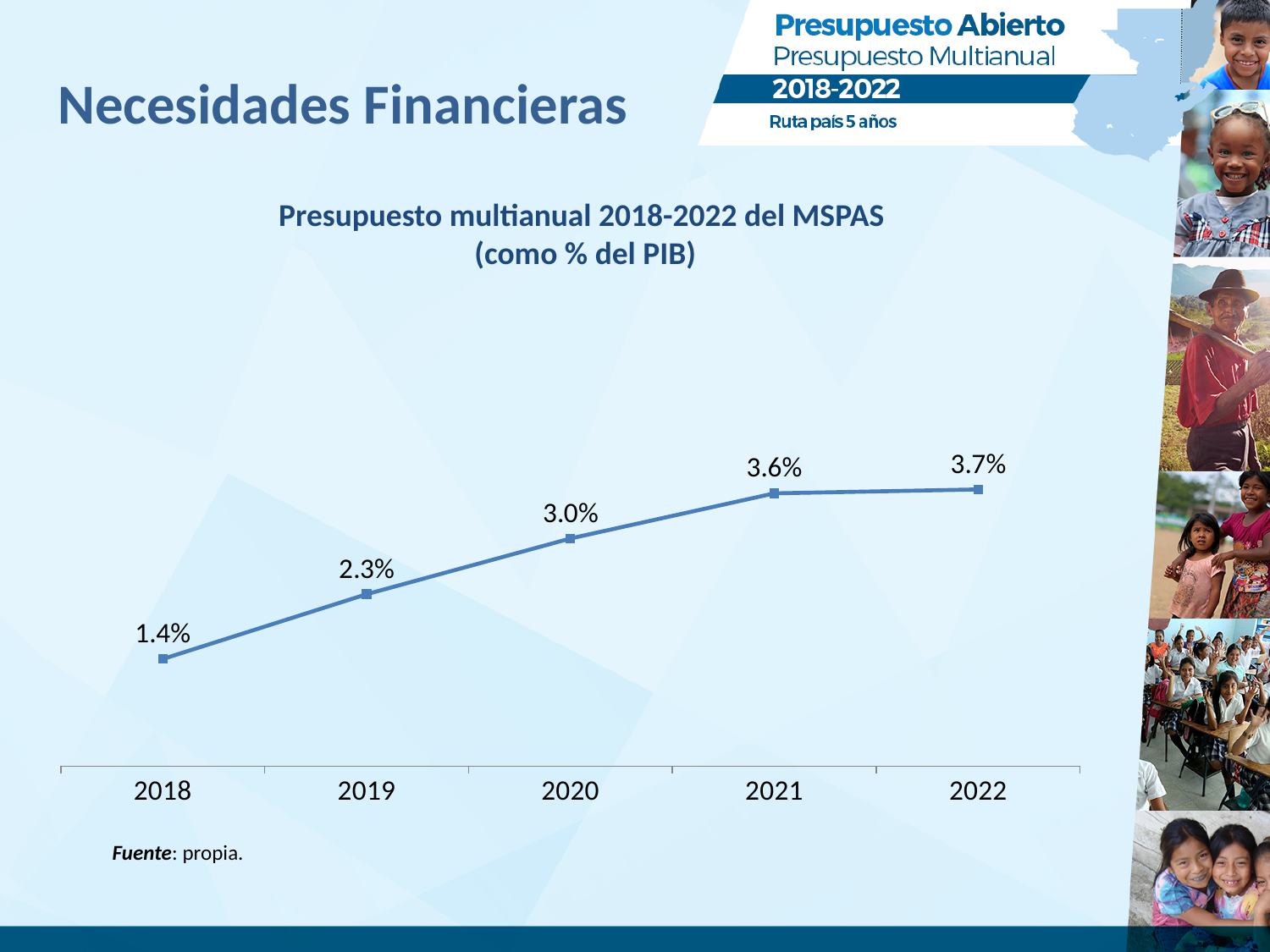
Which year has the lowest value? 2018 Which year has the highest value? 2022 What is the difference between the values for 2022 and 2018? 2.3% What is the value for 2020? 3.0% How many years are plotted on the chart? 5 What is the value for 2022? 3.7% What kind of chart is shown? line chart Which is larger, the value for 2019 or the value for 2020? 2020 What is the title of the chart? Presupuesto multianual 2018-2022 del MSPAS (como % del PIB) What is the difference between the values for 2021 and 2019? 1.3% What is the value for 2018? 1.4% Do the values rise or fall from 2018 to 2022? rise